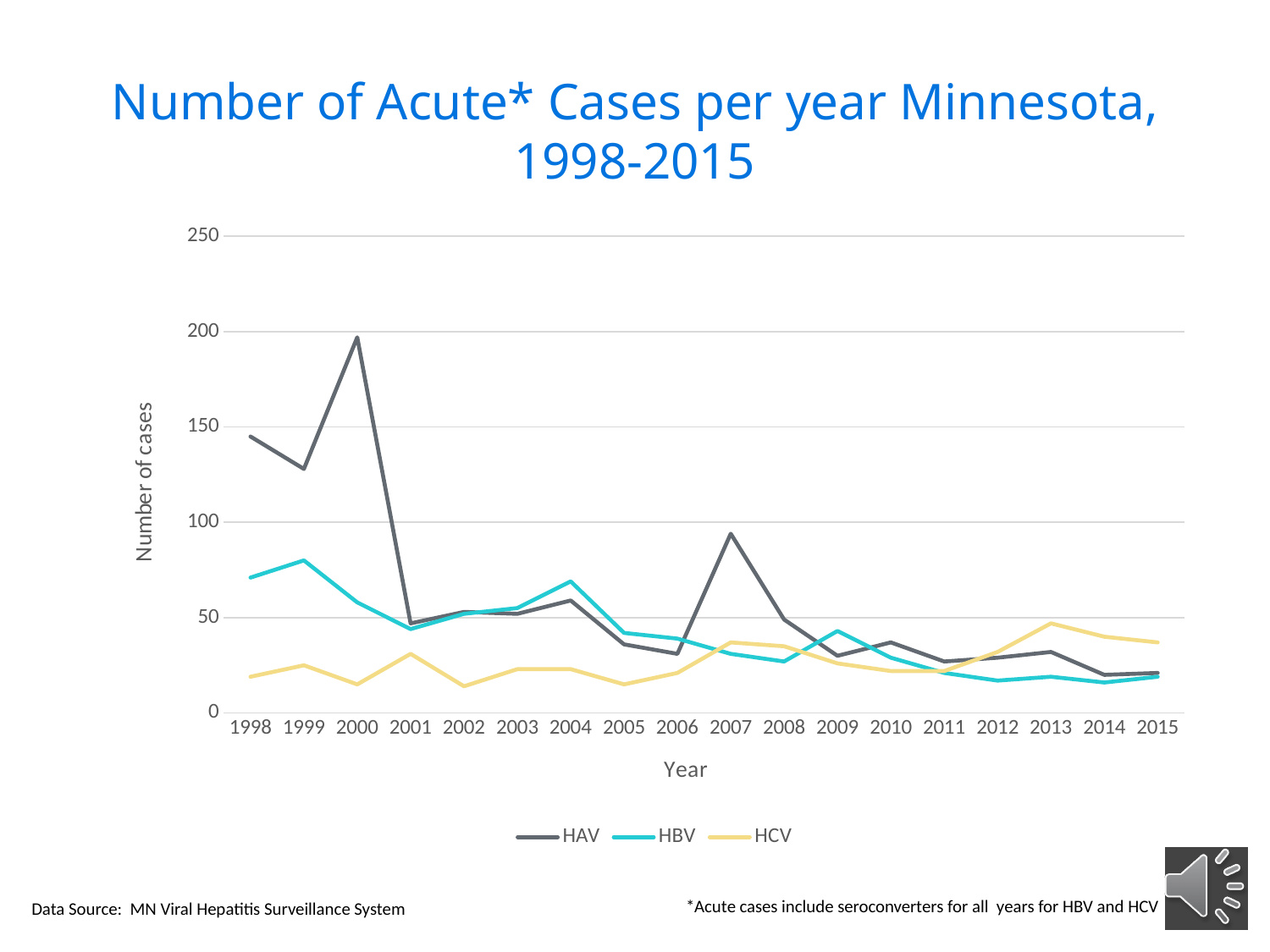
Is the value for HAV in 2007 greater or less than 100? less In which year does the HAV line reach its highest value? 2000 How many series does the legend list? 3 Is the value for HAV in 2000 greater or less than 150? greater Is the value for HCV in 2002 greater or less than 50? less Does the HAV line rise or fall between 2000 and 2001? fall What is the label of the y axis? Number of cases In 2000, which series has the higher value, HAV or HCV? HAV In which year does the HBV line reach its highest value? 1999 How many years are plotted along the x axis? 18 What kind of chart is shown on the slide? line chart